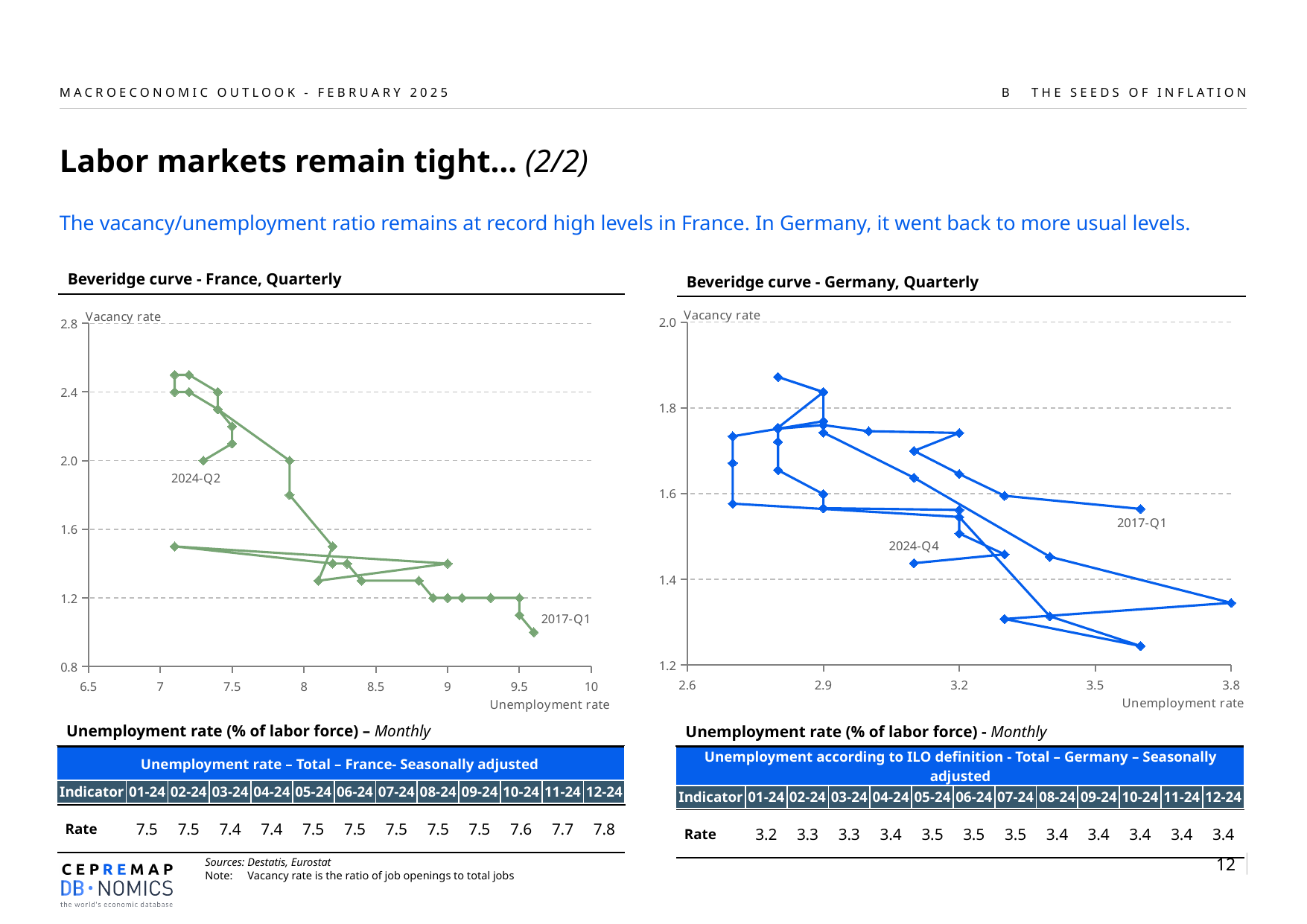
In the 'Beveridge curve - Germany, Quarterly' chart, what is the label of the y axis? Vacancy rate In the 'Beveridge curve - Germany, Quarterly' chart, is the vacancy rate at the point labeled 2017-Q1 greater or less than 1.8? less In the 'Beveridge curve - Germany, Quarterly' chart, is the unemployment rate at the point labeled 2024-Q4 greater or less than 3.2? less In the 'Beveridge curve - France, Quarterly' chart, does the vacancy rate generally rise or fall as the unemployment rate increases along the x axis? fall In the 'Beveridge curve - France, Quarterly' chart, is the vacancy rate at the point labeled 2017-Q1 greater or less than 1.2? less In the 'Beveridge curve - France, Quarterly' chart, which labeled point has the higher vacancy rate, 2024-Q2 or 2017-Q1? 2024-Q2 What kind of chart is the 'Beveridge curve - France, Quarterly' chart? scatter chart In the 'Beveridge curve - France, Quarterly' chart, what is the label of the x axis? Unemployment rate